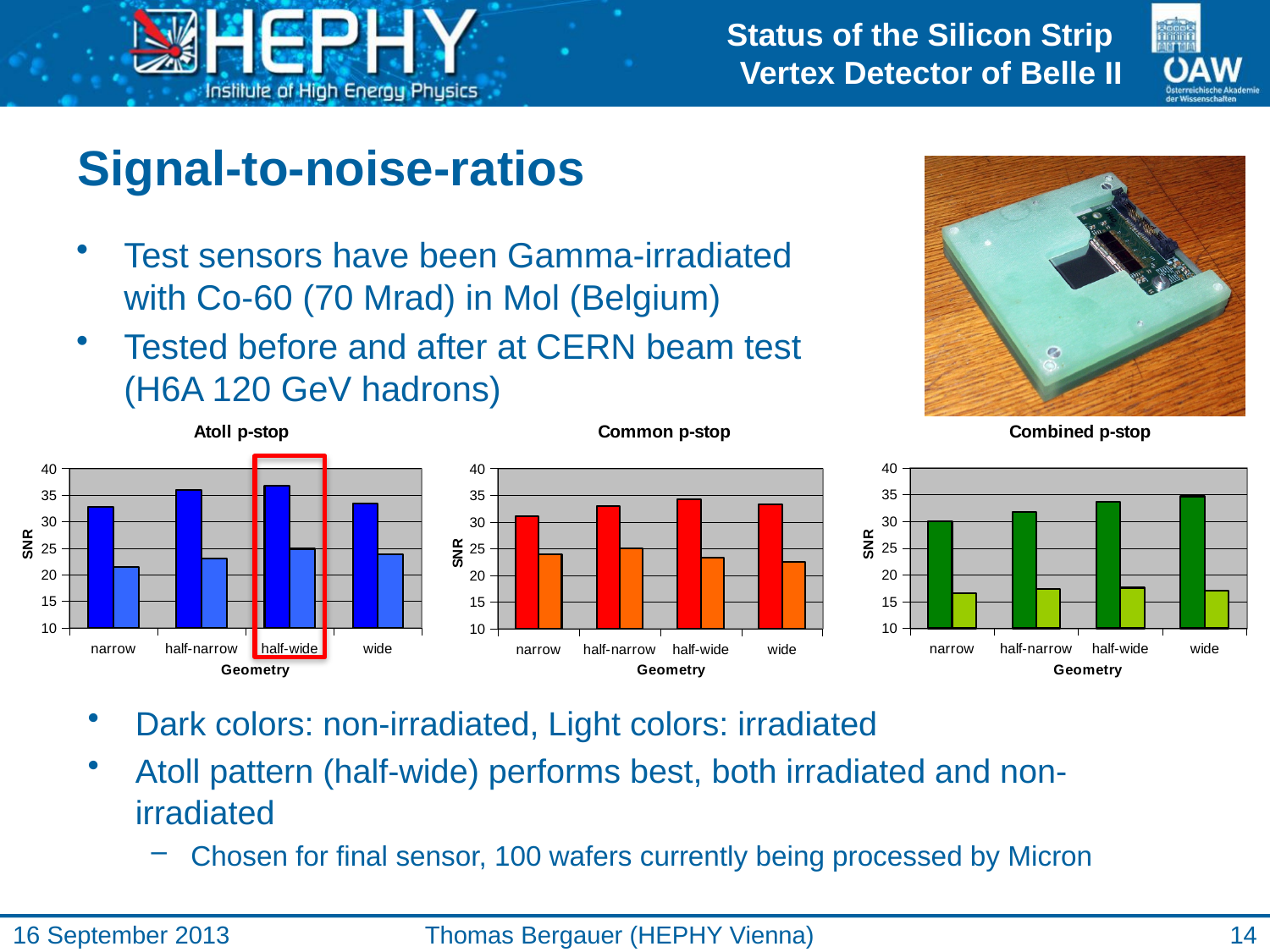
In the Atoll p-stop chart, for the half-wide geometry, which is larger: the non-irradiated (dark) bar or the irradiated (light) bar? non-irradiated (dark) In the Atoll p-stop chart, is the irradiated (light) SNR for narrow greater or less than 25? less In the Combined p-stop chart, is the irradiated (light) SNR for narrow greater or less than 20? less In the Common p-stop chart, is the non-irradiated (dark) SNR for half-wide greater or less than 30? greater In the Combined p-stop chart, which geometry has the highest non-irradiated (dark) SNR? wide In the Combined p-stop chart, do the dark (non-irradiated) bars rise or fall from narrow to wide? rise How many geometry categories are shown on the x axis of the Common p-stop chart? 4 What kind of chart is the Atoll p-stop chart? bar chart Which geometry in the Atoll p-stop chart is highlighted with a red box? half-wide In the Combined p-stop chart, which geometry has the lowest non-irradiated (dark) SNR? narrow What is the y-axis label on the three charts? SNR